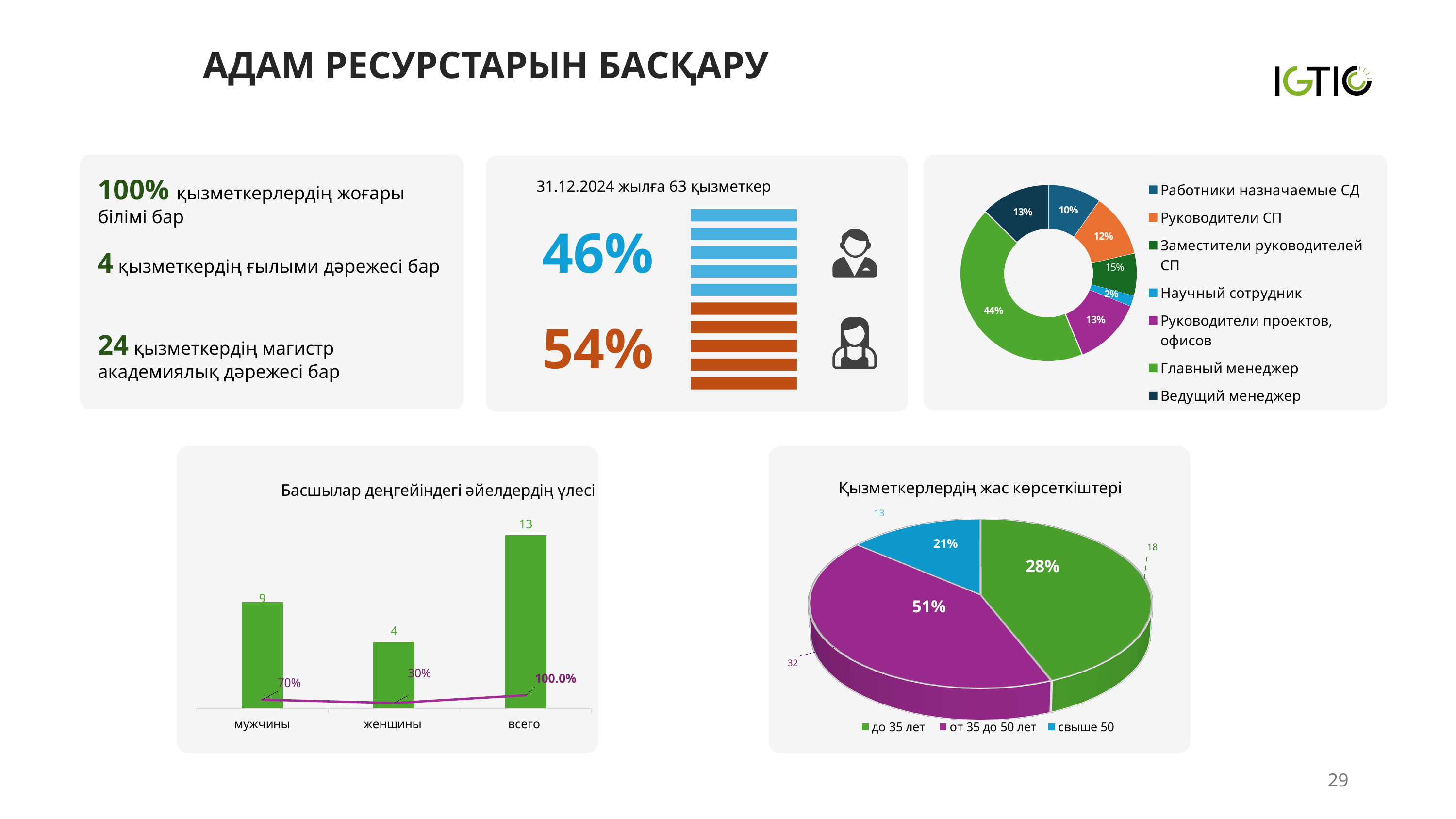
In the chart titled 'Қызметкерлердің жас көрсеткіштері', what share is shown for от 35 до 50 лет? 51% In the donut chart at the top right, what share is shown for Руководители СП? 12% In the chart titled 'Қызметкерлердің жас көрсеткіштері', which age group has the smallest slice? свыше 50 In the donut chart at the top right, which category has the smallest share? Научный сотрудник In the donut chart at the top right, what share is shown for Главный менеджер? 44% In the chart titled 'Басшылар деңгейіндегі әйелдердің үлесі', what is the difference between the bar values for мужчины and женщины? 5 In the chart titled 'Басшылар деңгейіндегі әйелдердің үлесі', what percentage is shown on the line for женщины? 30% In the chart titled 'Басшылар деңгейіндегі әйелдердің үлесі', what is the bar value for мужчины? 9 In the donut chart at the top right, what is the difference between the shares of Заместители руководителей СП and Работники назначаемые СД? 5% In the chart titled 'Басшылар деңгейіндегі әйелдердің үлесі', which category has the highest bar? всего What kind of chart is 'Қызметкерлердің жас көрсеткіштері'? Pie chart How many entries does the legend of the donut chart at the top right list? 7